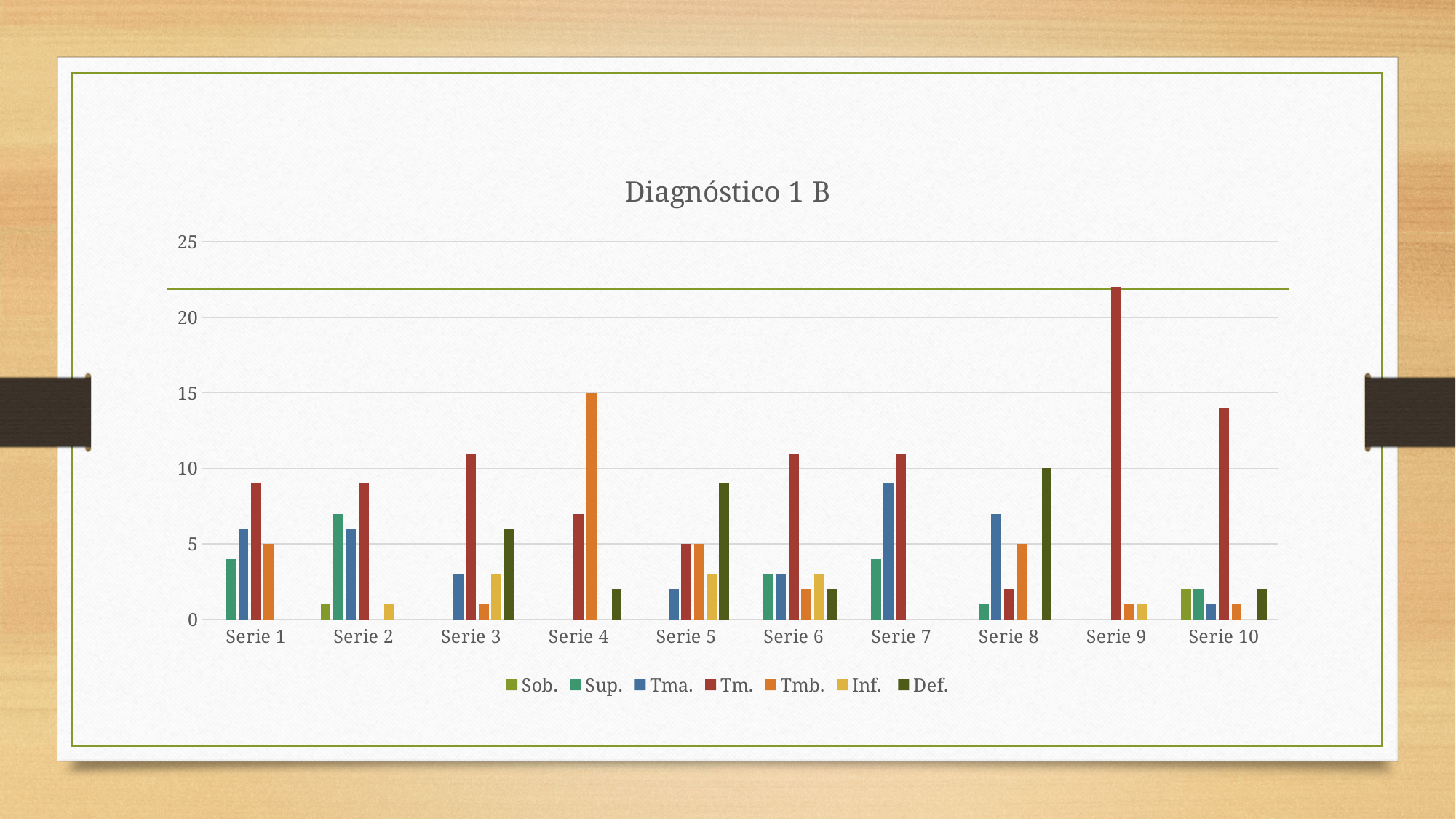
What is the value of Def. for Serie 8? 10 What is the title of the chart? Diagnóstico 1 B Is the value of Tm. for Serie 9 greater or less than 20? greater In which category does Tm. reach its highest value? Serie 9 What is the value of Tmb. for Serie 1? 5 What kind of chart is shown on the slide? bar chart Is the value of Tm. for Serie 10 greater or less than 10? greater How many categories are shown on the x axis? 10 How many series does the legend list? 7 Is the value of Sup. for Serie 2 greater or less than 5? greater For Serie 4, which is larger: Tm. or Tmb.? Tmb. What is the value of Tmb. for Serie 4? 15